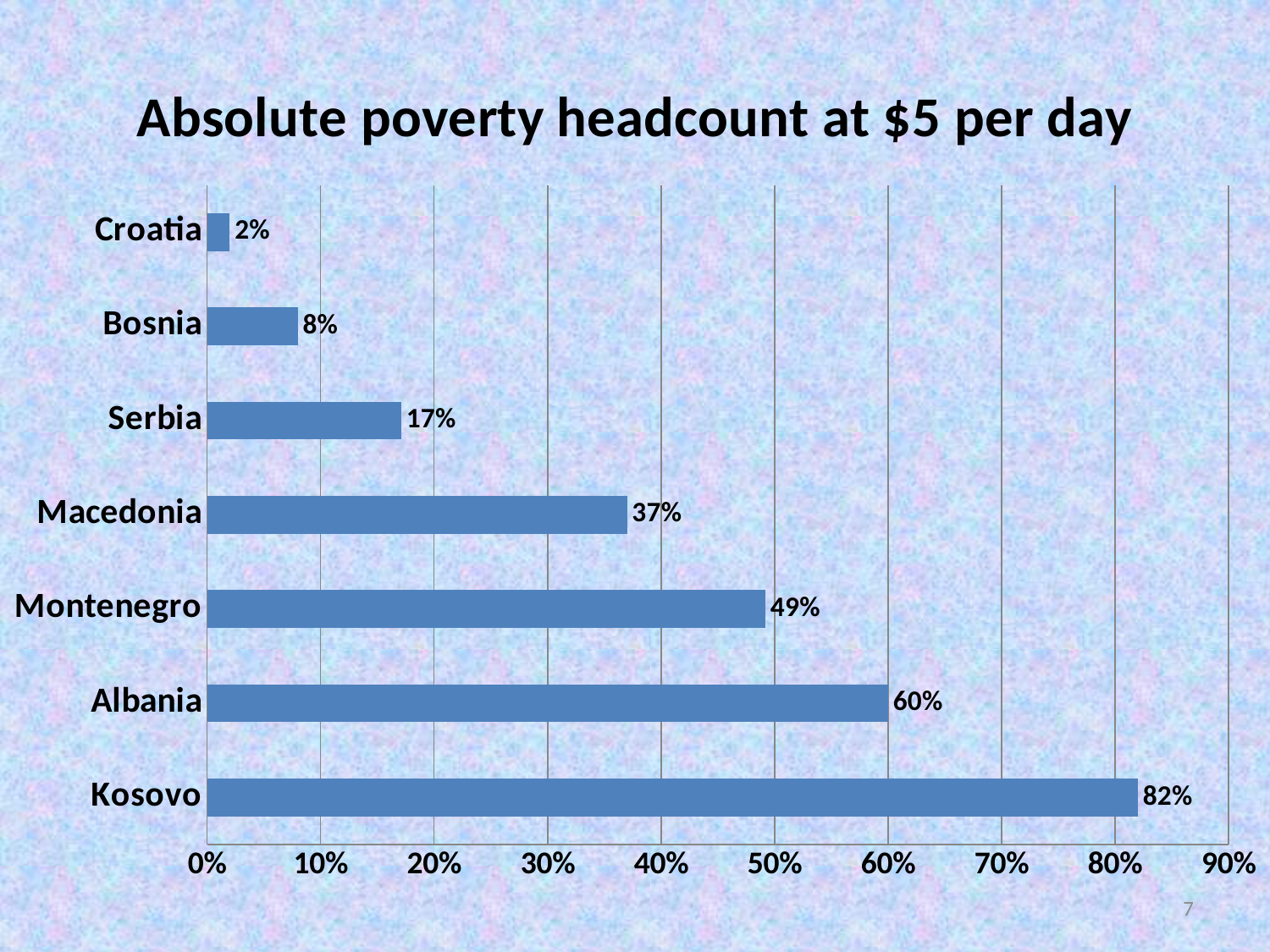
What is the title of the chart? Absolute poverty headcount at $5 per day Is the value for Albania greater or less than 50%? greater What is the value shown for Macedonia? 37% How many countries are shown on the chart? 7 What is the difference between the values for Albania and Montenegro? 11% What kind of chart is shown on the slide? Bar chart What is the absolute poverty headcount at $5 per day for Kosovo? 82% What is the value shown for Bosnia? 8% Which country has the lowest poverty headcount on the chart? Croatia What is the difference between the values for Serbia and Croatia? 15% Which has a higher poverty headcount, Montenegro or Macedonia? Montenegro Which country has the highest poverty headcount on the chart? Kosovo